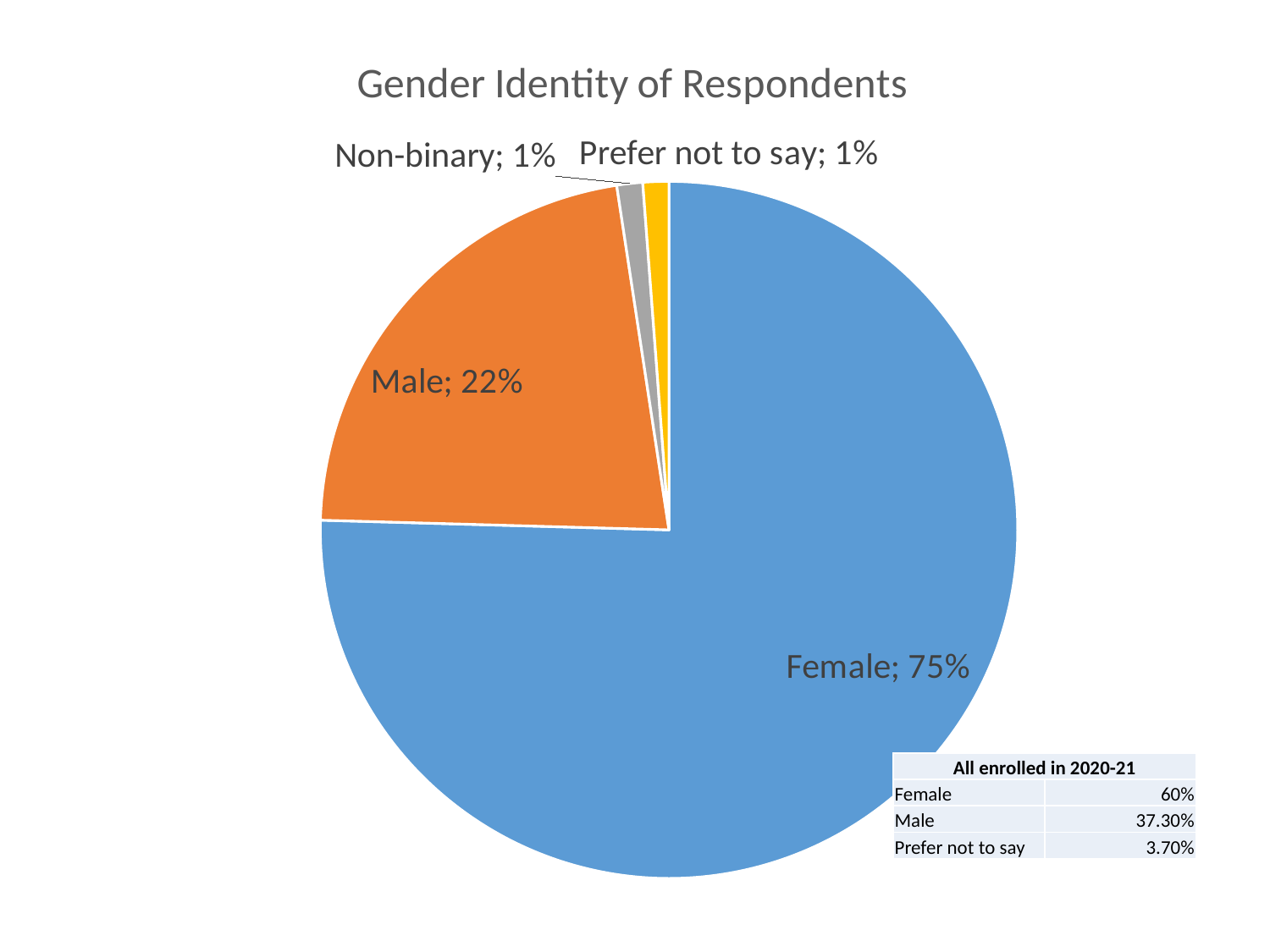
According to the table, what percentage of all enrolled in 2020-21 were Male? 37.30% Which slice is larger, Male or Non-binary? Male What kind of chart is shown on the slide? pie chart What percentage of respondents identified as Non-binary? 1% How many slices does the pie chart have? 4 Which colour is used for the Male slice? orange What is the title of the chart? Gender Identity of Respondents What percentage of respondents identified as Female? 75% What percentage of respondents identified as Male? 22% What is the difference in percentage points between the Female and Male slices? 53 What percentage of respondents chose Prefer not to say? 1% Which gender identity category has the largest share of respondents? Female